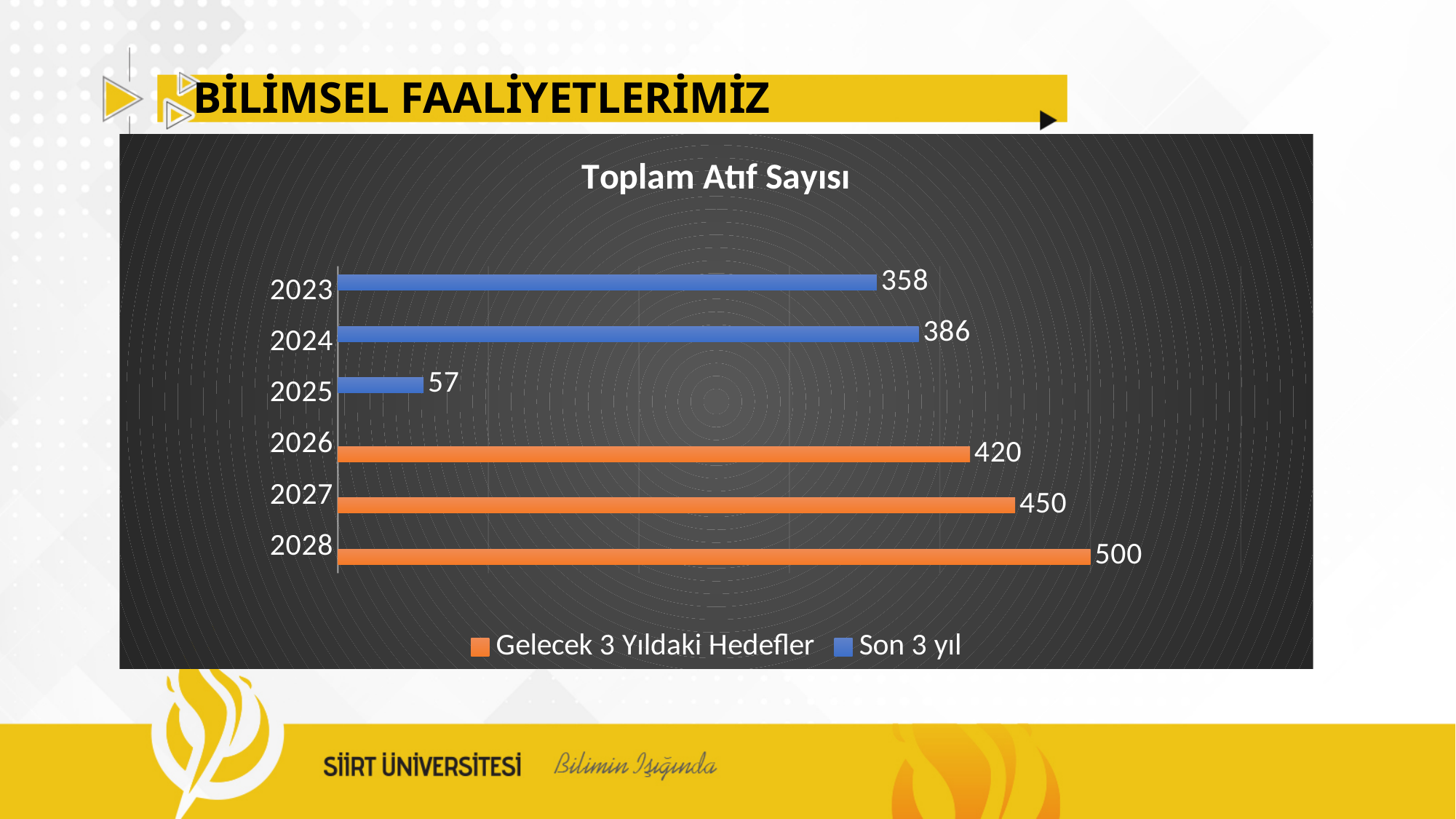
Which year has the highest value in the Toplam Atıf Sayısı chart? 2028 What is the value for 2028 in the Toplam Atıf Sayısı chart? 500 What is the value for 2025 in the Toplam Atıf Sayısı chart? 57 Which year has the lowest value in the Toplam Atıf Sayısı chart? 2025 How many years are shown in the Toplam Atıf Sayısı chart? 6 Which series in the Toplam Atıf Sayısı chart is shown in orange? Gelecek 3 Yıldaki Hedefler What is the difference between the values for 2024 and 2023 in the Toplam Atıf Sayısı chart? 28 Which is larger in the Toplam Atıf Sayısı chart, the value for 2027 or the value for 2024? 2027 What is the difference between the values for 2028 and 2026 in the Toplam Atıf Sayısı chart? 80 How many series does the legend of the Toplam Atıf Sayısı chart list? 2 What is the value for 2023 in the Toplam Atıf Sayısı chart? 358 What kind of chart is the Toplam Atıf Sayısı chart? Bar chart